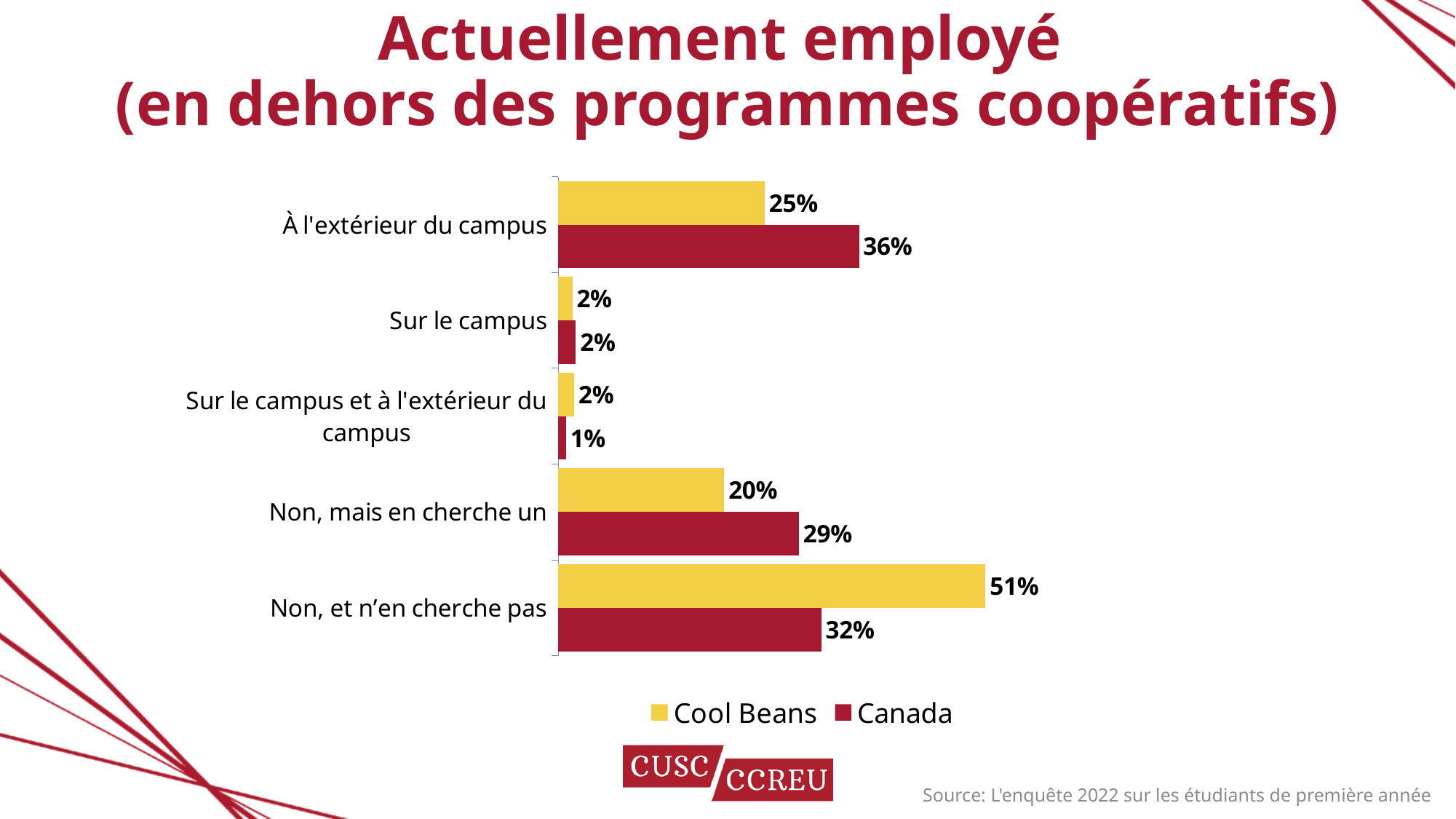
Which colour represents the Canada series? Dark red How many series does the legend list? 2 What is the Canada value for "Sur le campus et à l'extérieur du campus"? 1% How many categories are shown on the chart? 5 Which category has the lowest Canada value? Sur le campus et à l'extérieur du campus What kind of chart is shown on the slide? Bar chart What is the Canada value for "Non, mais en cherche un"? 29% For "Non, mais en cherche un", which series has the larger value, Cool Beans or Canada? Canada What is the difference between the Cool Beans and Canada values for "Non, et n'en cherche pas"? 19% Which category has the highest Cool Beans value? Non, et n'en cherche pas What is the difference between the Canada and Cool Beans values for "À l'extérieur du campus"? 11% What is the Cool Beans value for "À l'extérieur du campus"? 25%